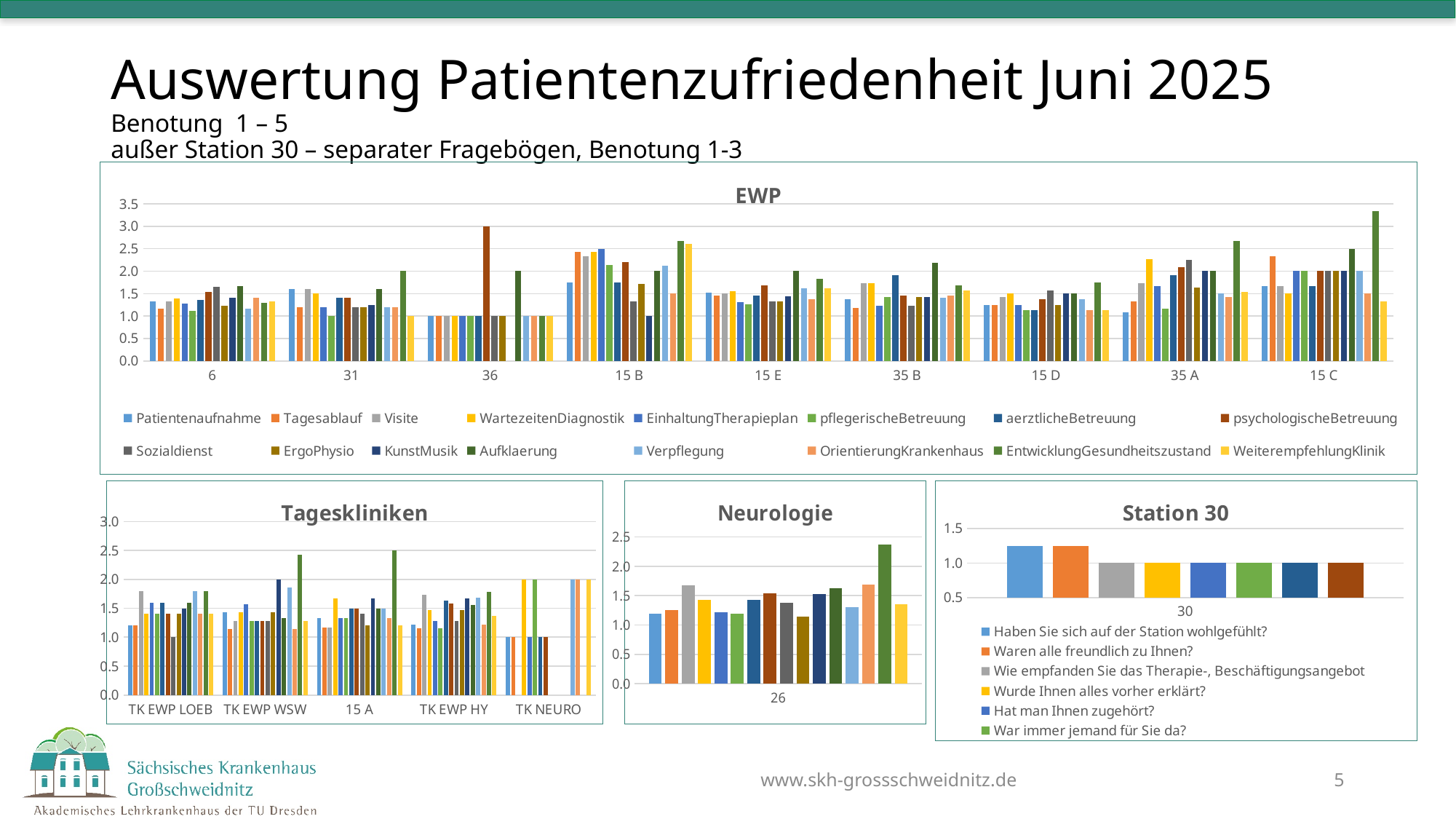
In the Station 30 chart, what is the value for "Wie empfanden Sie das Therapie-, Beschäftigungsangebot"? 1.0 How many categories are shown on the x axis of the Tageskliniken chart? 5 In the EWP chart, what is the highest value shown on the y axis? 3.5 In the EWP chart, is the value for psychologischeBetreuung at category 36 greater or less than 2.5? greater What kind of chart is the EWP chart? bar chart How many categories are shown on the x axis of the EWP chart? 9 How many series does the legend of the EWP chart list? 16 In the Neurologie chart, what is the label of the single category on the x axis? 26 In the Neurologie chart, is the tallest bar greater or less than 2.0? greater In the EWP chart, which category contains the tallest bar? 15 C In the Station 30 chart, which is larger: the value for "Haben Sie sich auf der Station wohlgefühlt?" or for "Wurde Ihnen alles vorher erklärt?"? Haben Sie sich auf der Station wohlgefühlt? What is the title of the chart in the bottom middle of the slide? Neurologie